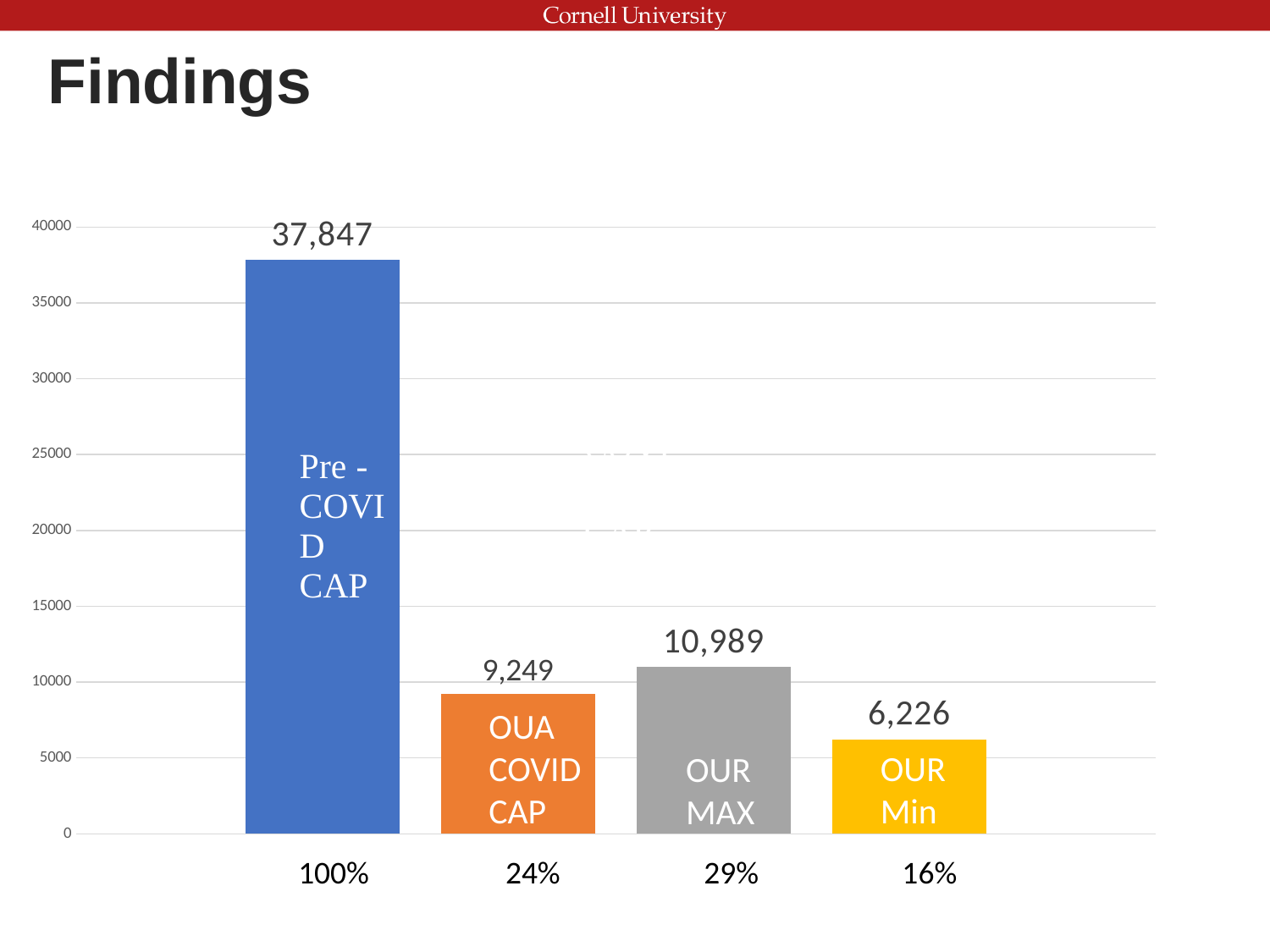
What is the value of the OUR Min bar? 6,226 What is the value of the OUR MAX bar? 10,989 What kind of chart is shown on the slide? Bar chart What is the value of the Pre-COVID CAP bar? 37,847 Which is larger, OUR MAX or OUA COVID CAP? OUR MAX What percentage is shown below the OUR MAX bar? 29% How many bars are shown in the chart? 4 What is the value of the OUA COVID CAP bar? 9,249 Which bar has the lowest value? OUR Min What is the difference between the Pre-COVID CAP value and the OUR Min value? 31,621 What is the difference between the OUR MAX value and the OUA COVID CAP value? 1,740 Which bar has the highest value? Pre-COVID CAP